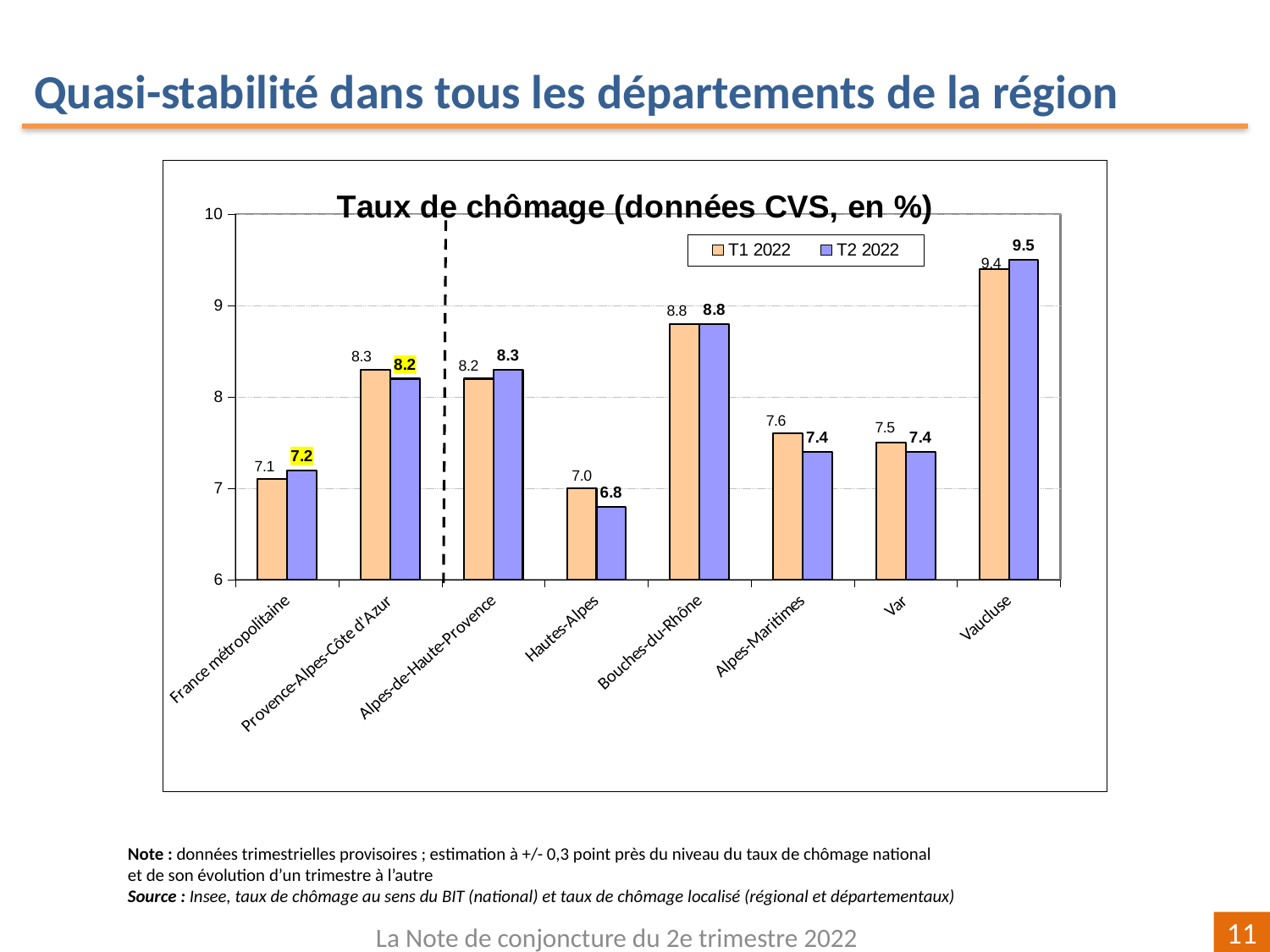
Which category has the lowest T2 2022 unemployment rate? Hautes-Alpes Which category has the highest T2 2022 unemployment rate? Vaucluse How many series does the legend list? 2 What is the T1 2022 unemployment rate for Hautes-Alpes? 7.0 What is the T2 2022 value for Provence-Alpes-Côte d'Azur? 8.2 What is the T2 2022 unemployment rate for Vaucluse? 9.5 How many categories are shown on the x axis? 8 What kind of chart is shown on the slide? Bar chart Is the T1 2022 value for Bouches-du-Rhône greater or less than 8? greater Which is larger for Var: the T1 2022 value or the T2 2022 value? T1 2022 What is the difference between the T1 2022 and T2 2022 values for Alpes-Maritimes? 0.2 What is the title of the chart? Taux de chômage (données CVS, en %)